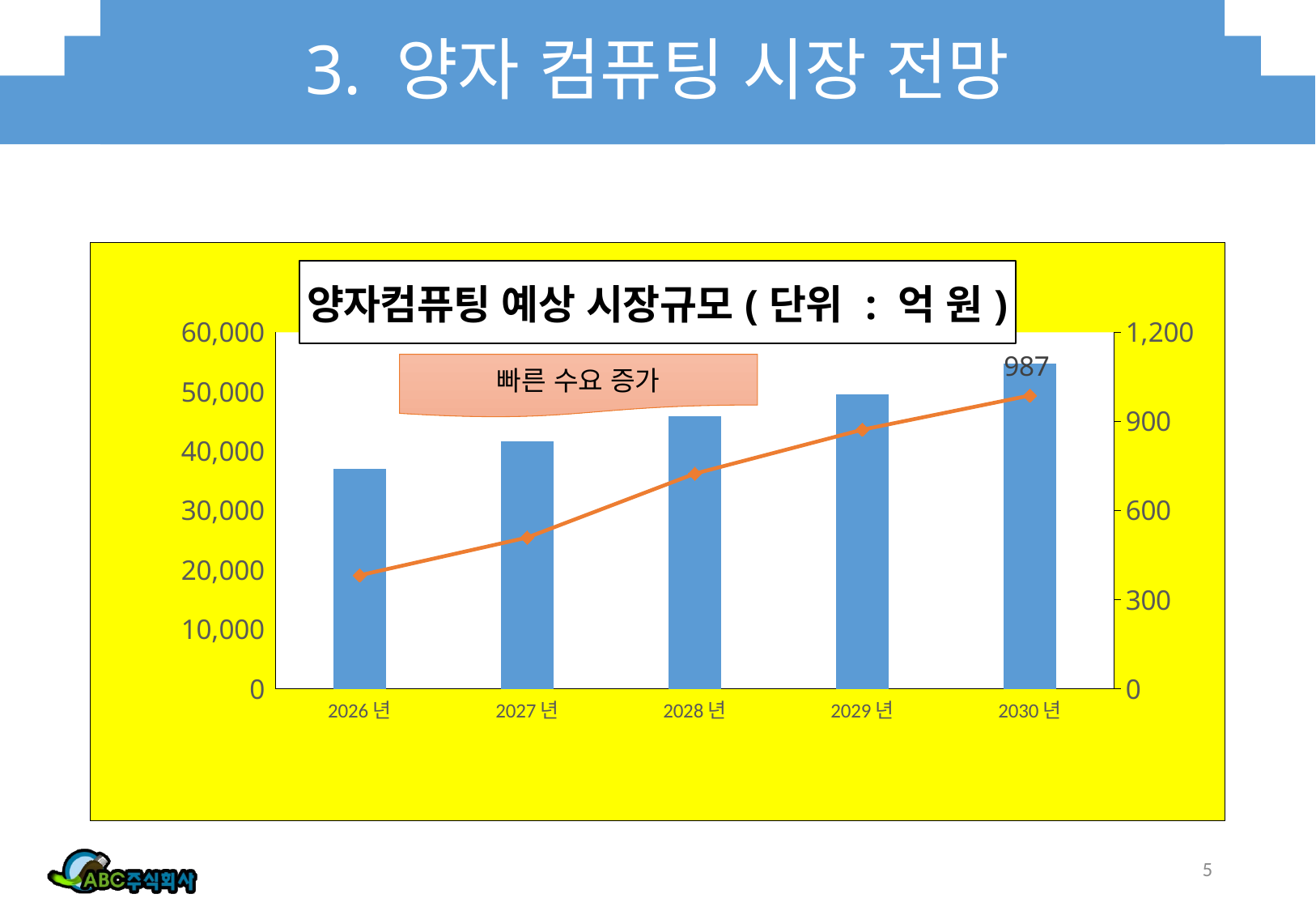
What kind of chart is this? A bar chart combined with a line chart Which year has the shortest bar? 2026 년 Which year has the tallest bar? 2030 년 Do the bar values rise or fall from 2026 년 to 2030 년? Rise What is the title of the chart? 양자컴퓨팅 예상 시장규모 ( 단위 : 억 원 ) Which bar is taller, 2027 년 or 2029 년? 2029 년 Is the line value for 2026 년 greater or less than 600 on the right axis? less Is the bar value for 2030 년 greater or less than 50,000? greater Is the bar value for 2026 년 greater or less than 40,000? less What is the data label shown on the line at 2030 년? 987 How many years are shown on the x axis? 5 What text is written in the callout box above the bars? 빠른 수요 증가